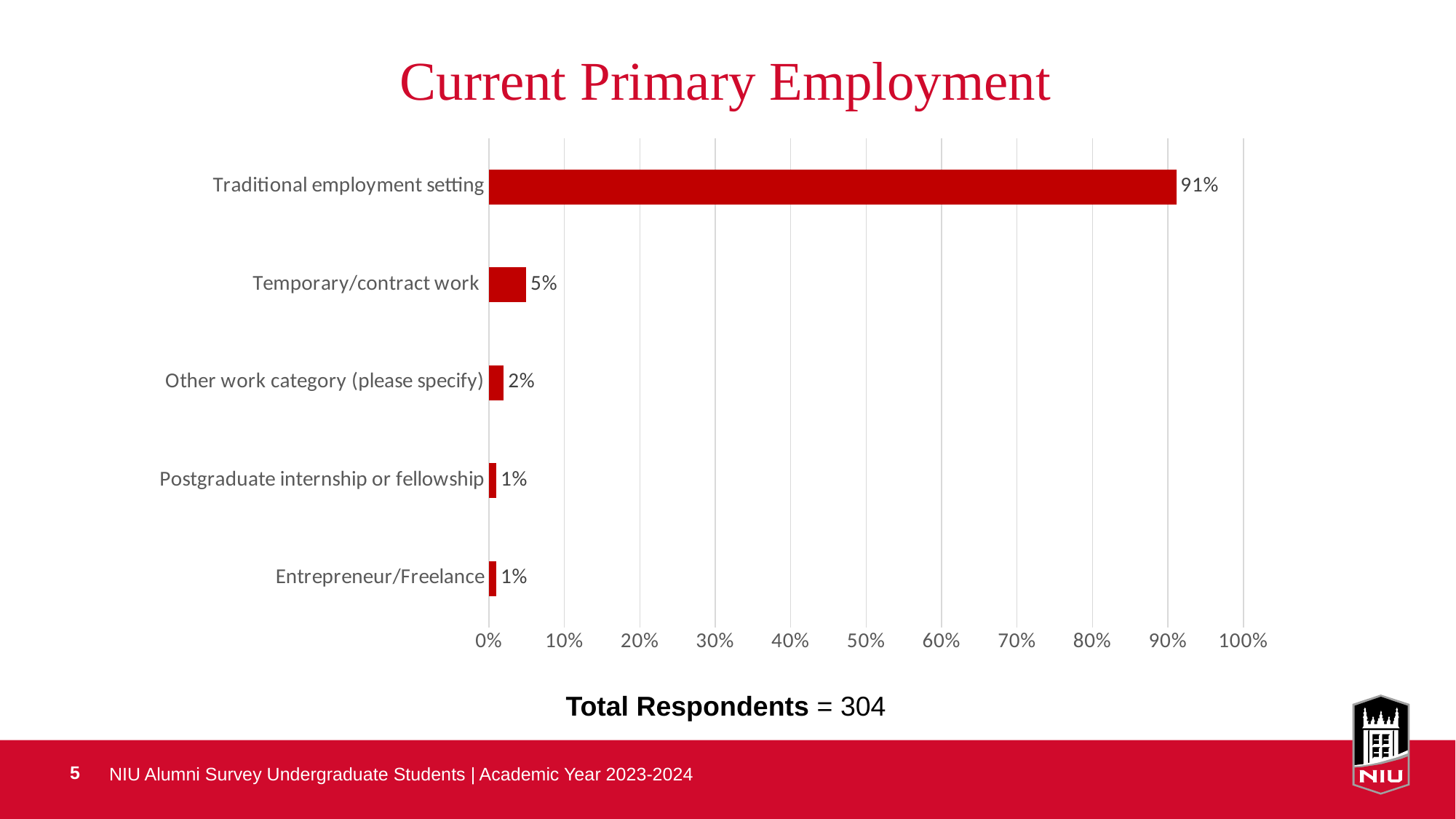
What is the difference between Temporary/contract work and Other work category (please specify)? 3% What percentage is shown for Other work category (please specify)? 2% What percentage of respondents are in a traditional employment setting? 91% Which category has the highest value? Traditional employment setting Is the value for Traditional employment setting greater or less than 80%? greater Which is larger, Temporary/contract work or Entrepreneur/Freelance? Temporary/contract work What is the value for Postgraduate internship or fellowship? 1% What is the difference between Traditional employment setting and Temporary/contract work? 86% What is the title of the chart? Current Primary Employment What is the value for Temporary/contract work? 5% What kind of chart is shown on the slide? Bar chart How many categories are shown in the chart? 5